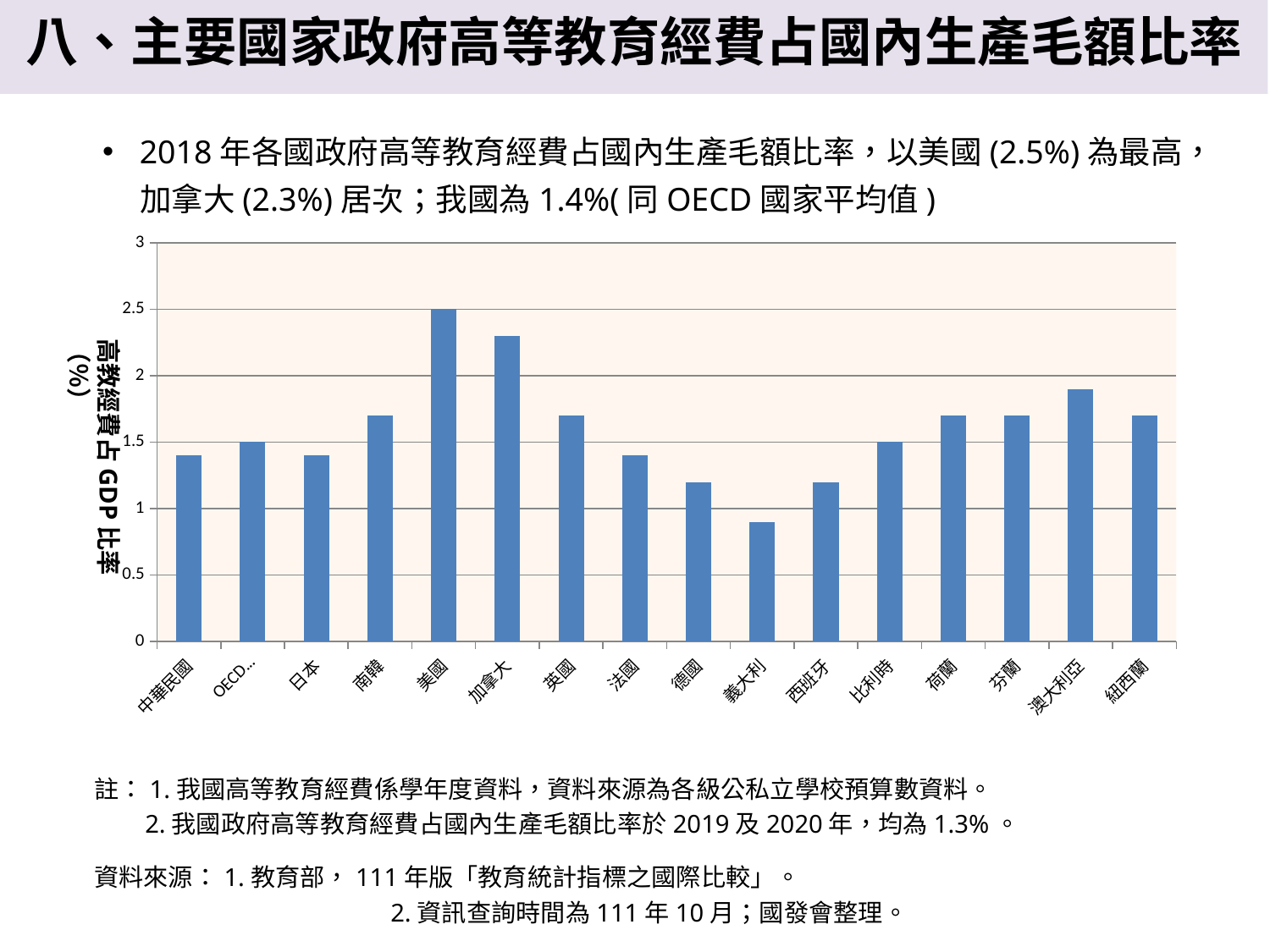
Which country has the lowest bar in the chart? 義大利 Is the value for 義大利 greater or less than 1? less According to the slide, what is the ratio for 加拿大? 2.3% Which is larger, the value for 南韓 or the value for 德國? 南韓 Is the value for 荷蘭 greater or less than 1.5? greater Which country has the highest bar in the chart? 美國 What is the value for 美國 in the chart? 2.5 What is the difference between the values for 美國 and 加拿大 as stated on the slide? 0.2 According to the slide, what is the ratio for 中華民國? 1.4% What kind of chart is shown on the slide? bar chart What is the title of the vertical axis of the chart? 高教經費占GDP比率(%) How many countries/categories are plotted on the x axis of the chart? 16